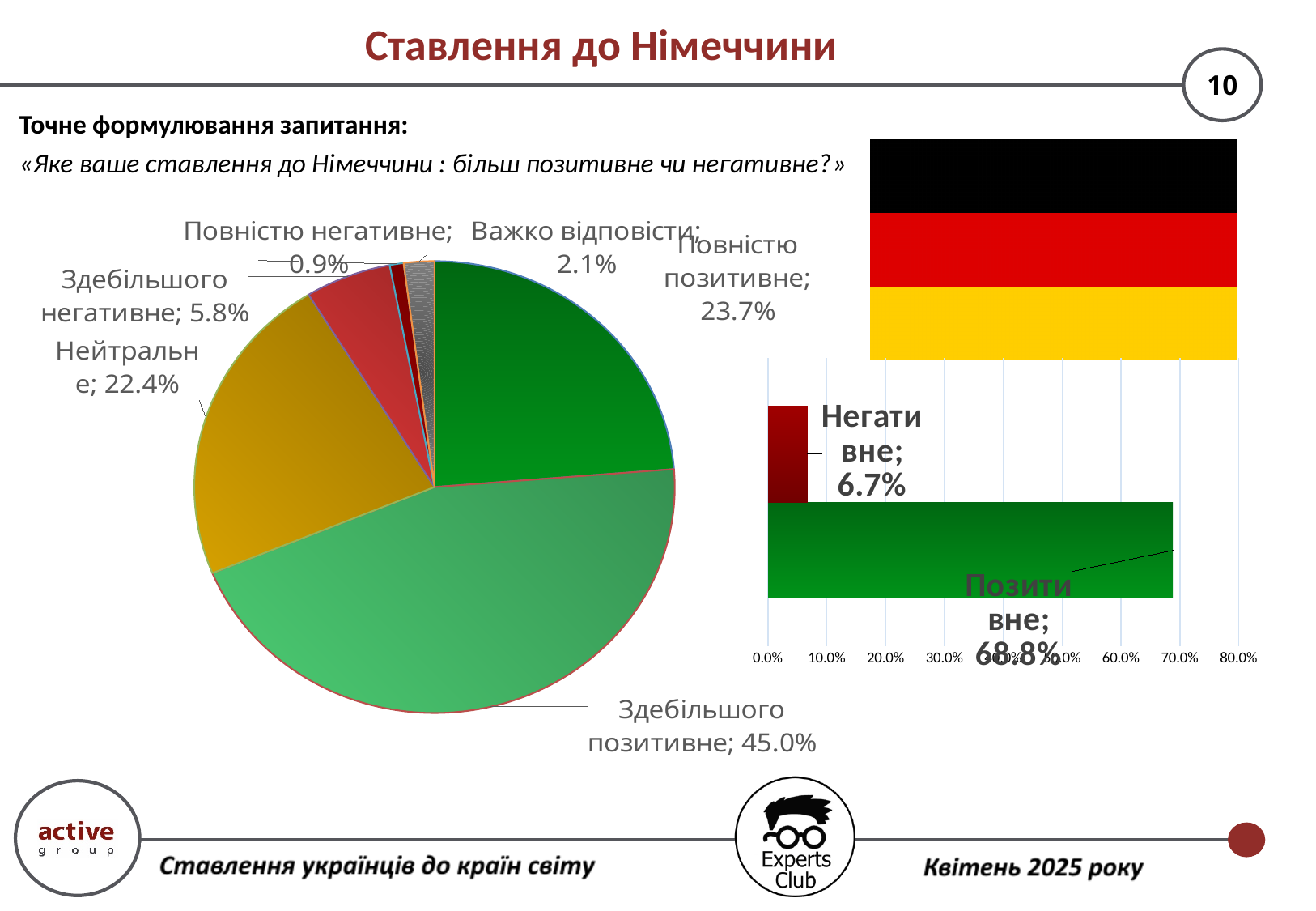
In the bar chart on the right, what is the difference between "Позитивне" and "Негативне"? 62.1% In the pie chart on the left, what share is labelled "Повністю позитивне"? 23.7% In the pie chart on the left, which category has the smallest slice? Повністю негативне In the pie chart on the left, what share is labelled "Здебільшого позитивне"? 45.0% In the pie chart on the left, what is the difference between "Здебільшого негативне" and "Важко відповісти"? 3.7% In the bar chart on the right, what is the value for "Негативне"? 6.7% What type of chart is shown on the right side of the slide? Bar chart In the pie chart on the left, how many slices are there? 6 In the pie chart on the left, which category has the largest slice? Здебільшого позитивне In the bar chart on the right, what is the value for "Позитивне"? 68.8% In the pie chart on the left, what share is labelled "Повністю негативне"? 0.9% In the pie chart on the left, what share is labelled "Нейтральне"? 22.4%